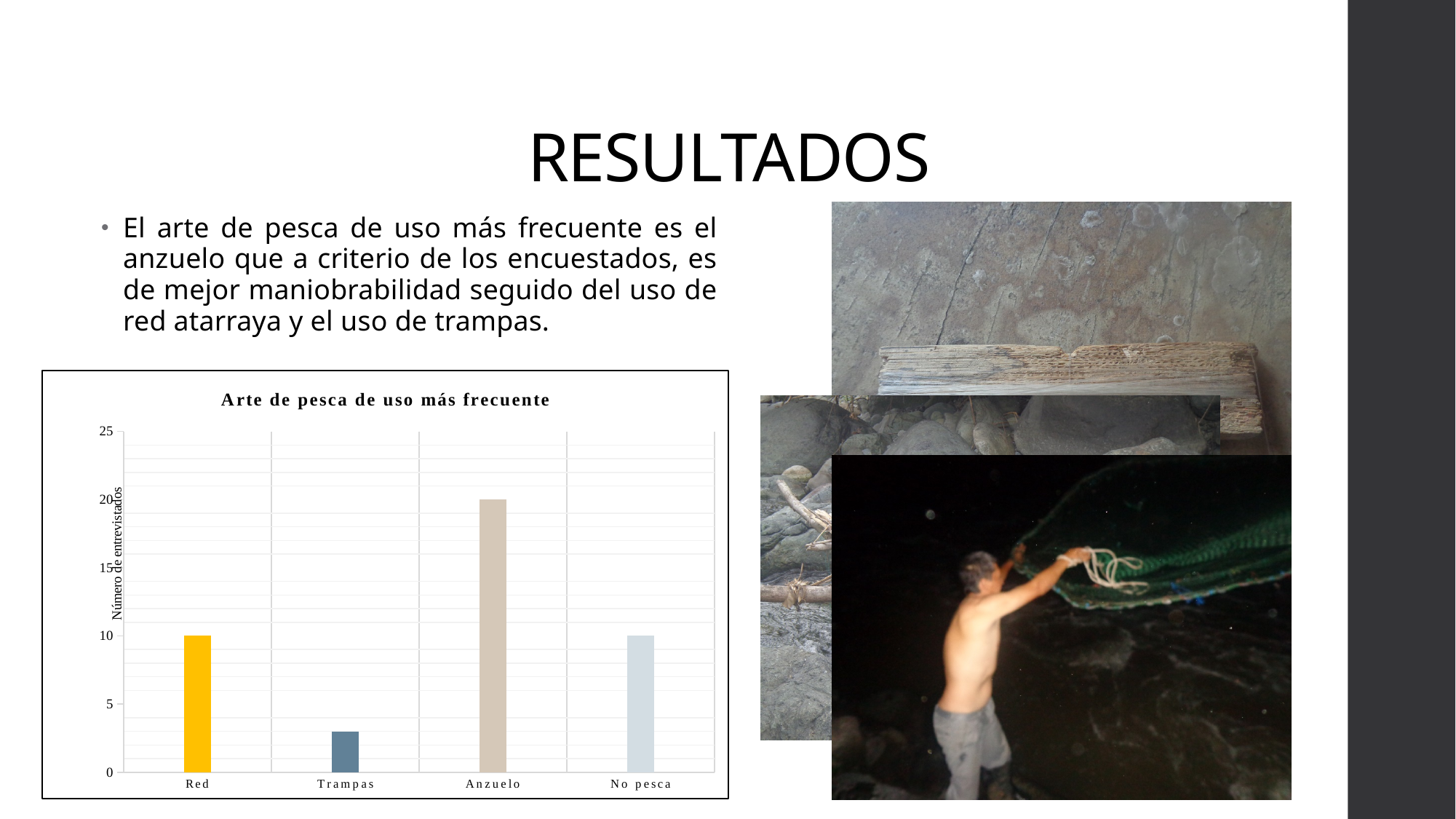
What type of chart is shown on the slide? bar chart Which category has the lowest value in the chart? Trampas What is the difference between the value for Anzuelo and the value for Red? 10 Which is larger, the value for Anzuelo or the value for Trampas? Anzuelo Which category has the highest value in the chart? Anzuelo Is the value for Trampas greater or less than 5? less What is the label of the vertical axis of the chart? Número de entrevistados What is the value for Red? 10 What is the title of the chart? Arte de pesca de uso más frecuente What is the value for No pesca? 10 How many categories are shown on the x axis of the chart? 4 What is the value for Anzuelo? 20